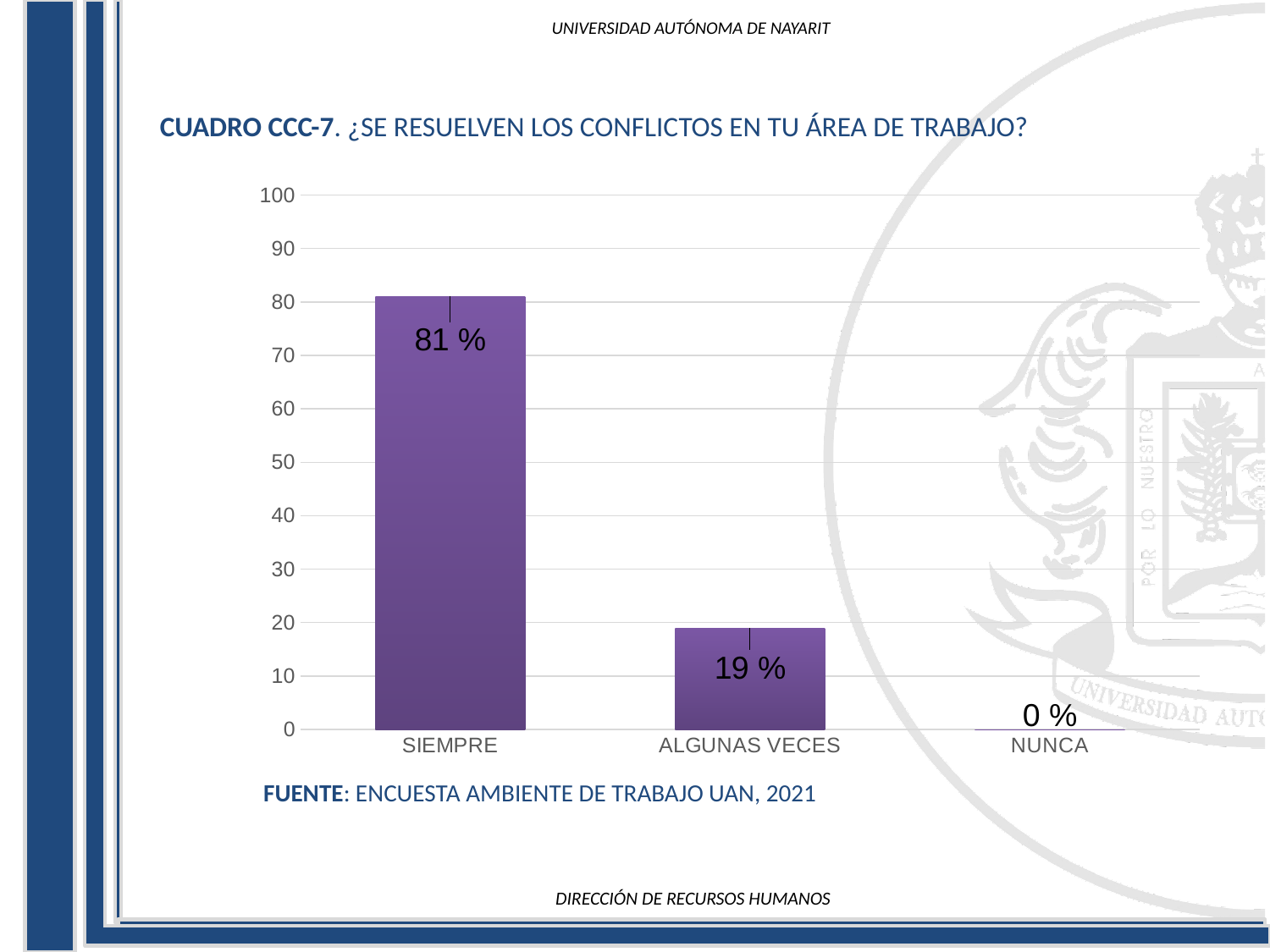
Is the value for SIEMPRE greater or less than 80? greater What kind of chart is shown on the slide? bar chart What is the value for NUNCA? 0 % What is the difference between the values for SIEMPRE and ALGUNAS VECES? 62 % Do the values rise or fall from left to right along the x axis? fall Which category has the lowest value? NUNCA What is the value for ALGUNAS VECES? 19 % Is the value for ALGUNAS VECES greater or less than 20? less What is the value for SIEMPRE? 81 % Which category has the highest value? SIEMPRE How many categories are shown on the x axis? 3 Which is larger, the value for SIEMPRE or the value for ALGUNAS VECES? SIEMPRE